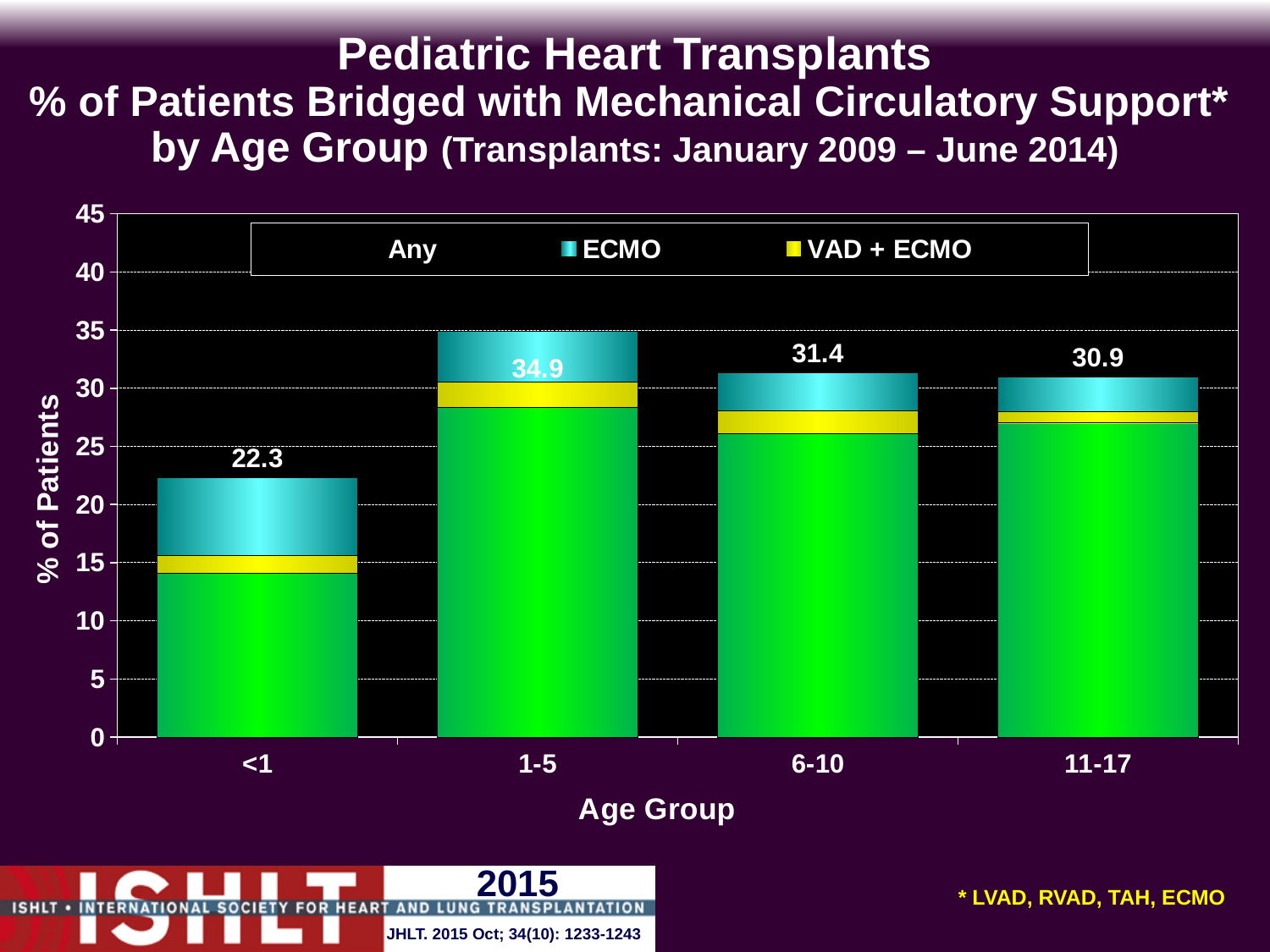
What is the difference between the labeled values for the 1-5 and <1 age groups? 12.6 What is the total value labeled for the <1 age group? 22.3 How many age groups are shown on the x axis? 4 Is the total value for the <1 age group greater or less than 25? less Which age group has a larger labeled value, 6-10 or 11-17? 6-10 What is the total value labeled for the 11-17 age group? 30.9 What is the total value labeled for the 1-5 age group? 34.9 How many series does the legend list? 3 Which age group has the lowest labeled percentage of patients bridged with mechanical circulatory support? <1 What is the total value labeled for the 6-10 age group? 31.4 Which age group has the highest labeled percentage of patients bridged with mechanical circulatory support? 1-5 What kind of chart is shown on the slide? Stacked bar chart